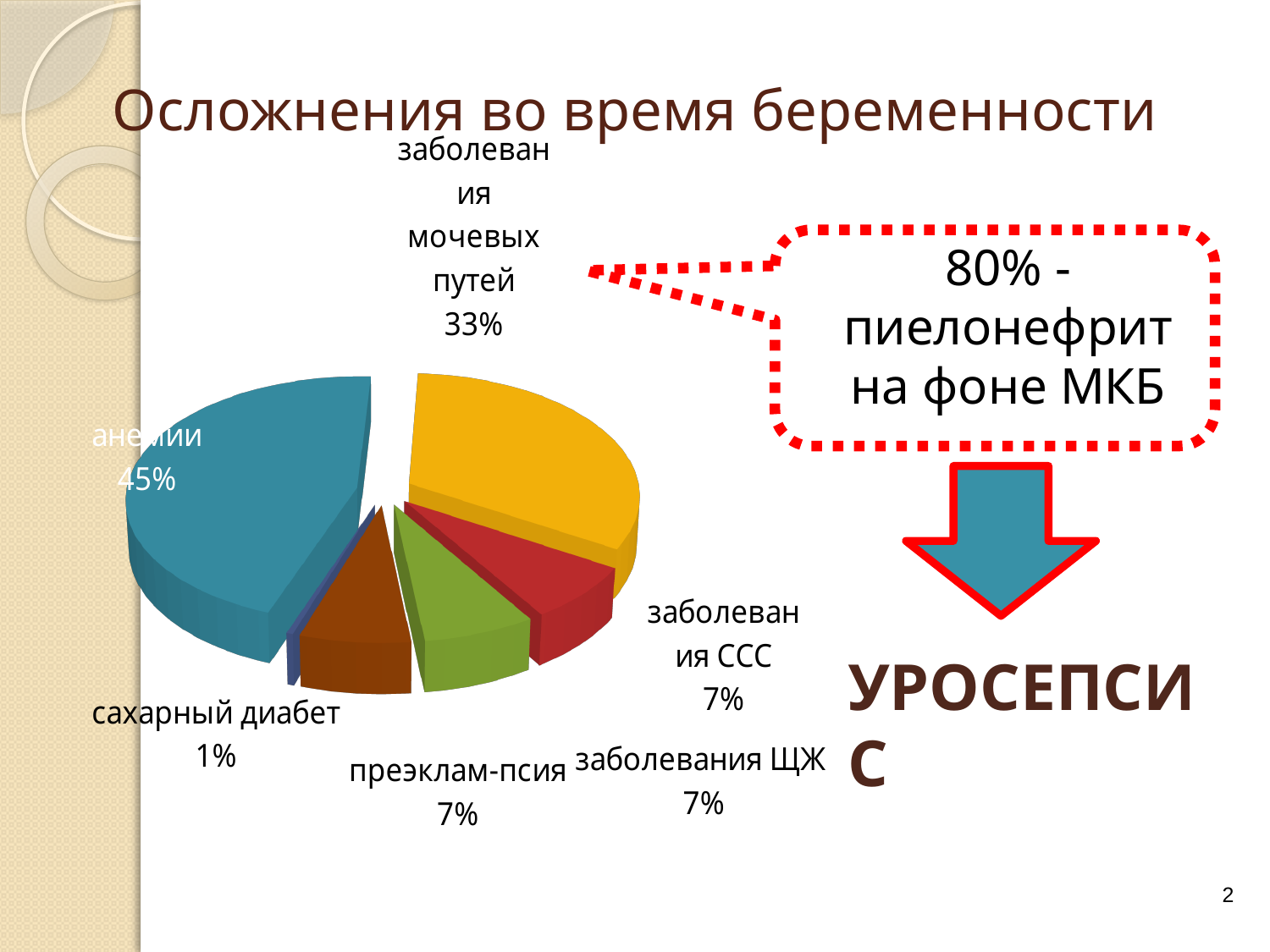
How many categories (slices) does the pie chart have? 6 What kind of chart is shown on the slide? pie chart What percentage is shown for "сахарный диабет"? 1% Which is larger: the slice for "заболевания мочевых путей" or the slice for "заболевания ЩЖ"? заболевания мочевых путей What is the difference in percentage points between "анемии" and "заболевания мочевых путей"? 12 What is the title of the slide containing the pie chart? Осложнения во время беременности What percentage is shown for "преэклам-псия"? 7% What percentage is shown for "заболевания ССС"? 7% Which category has the largest slice of the pie chart? анемии What percentage is shown for "заболевания мочевых путей"? 33% What share of the pie chart is labelled "анемии"? 45% Which category has the smallest slice of the pie chart? сахарный диабет